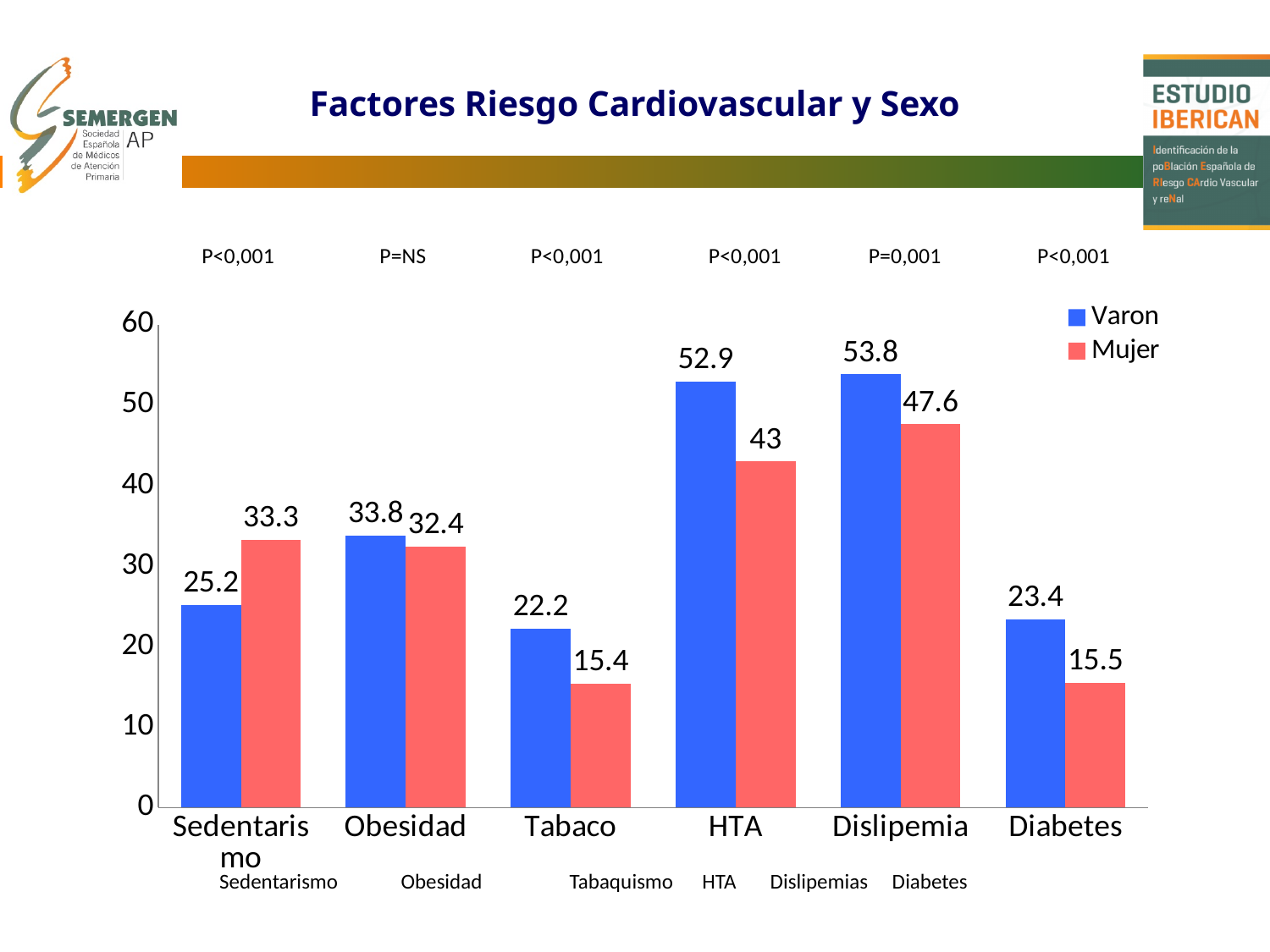
Which category has the lowest Mujer value? Tabaco What is the Mujer value for Sedentarismo? 33.3 What is the title of the slide? Factores Riesgo Cardiovascular y Sexo Which category has the highest Varon value? Dislipemia What kind of chart is shown on the slide? bar chart Which is larger for Obesidad, the Varon value or the Mujer value? Varon Is the Mujer value for HTA greater or less than 40? greater How many categories are shown on the x axis? 6 What is the Varon value for HTA? 52.9 What is the Mujer value for Tabaco? 15.4 What is the difference between the Varon and Mujer values for Dislipemia? 6.2 How many series does the legend list? 2